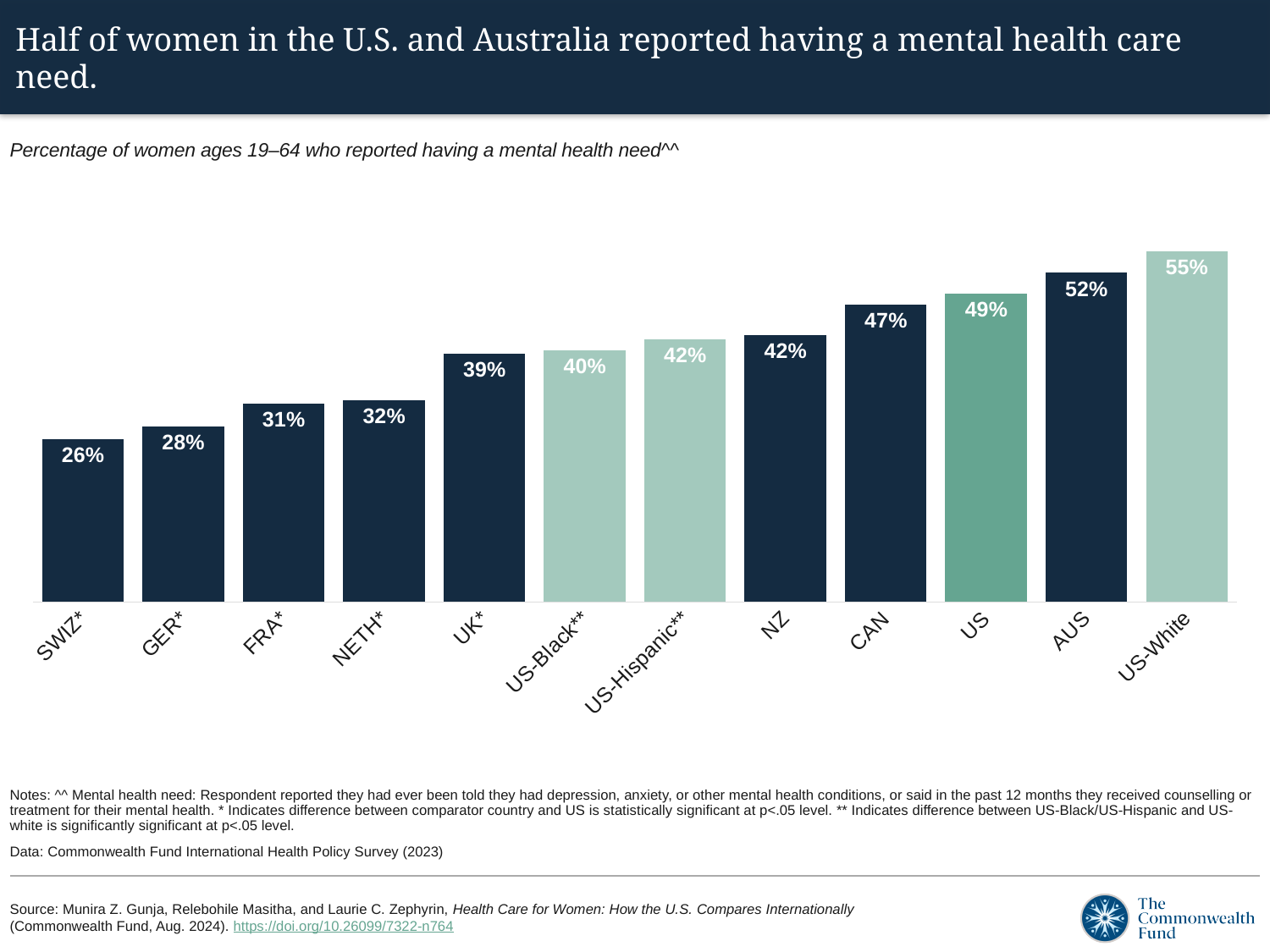
How many categories are shown on the chart? 12 Do the values rise or fall moving from left to right along the x axis? Rise What kind of chart is shown on the slide? Bar chart What is the value shown for AUS? 52% Which category has the highest value? US-White What percentage of women in the US reported having a mental health need? 49% What is the value shown for US-Black**? 40% What is the difference between the values for AUS and SWIZ*? 26 percentage points Which category has the lowest value? SWIZ* What is the chart's subtitle describing the measure plotted? Percentage of women ages 19–64 who reported having a mental health need What is the difference between the values for US-White and US-Black**? 15 percentage points Which is larger, the value for CAN or the value for UK*? CAN